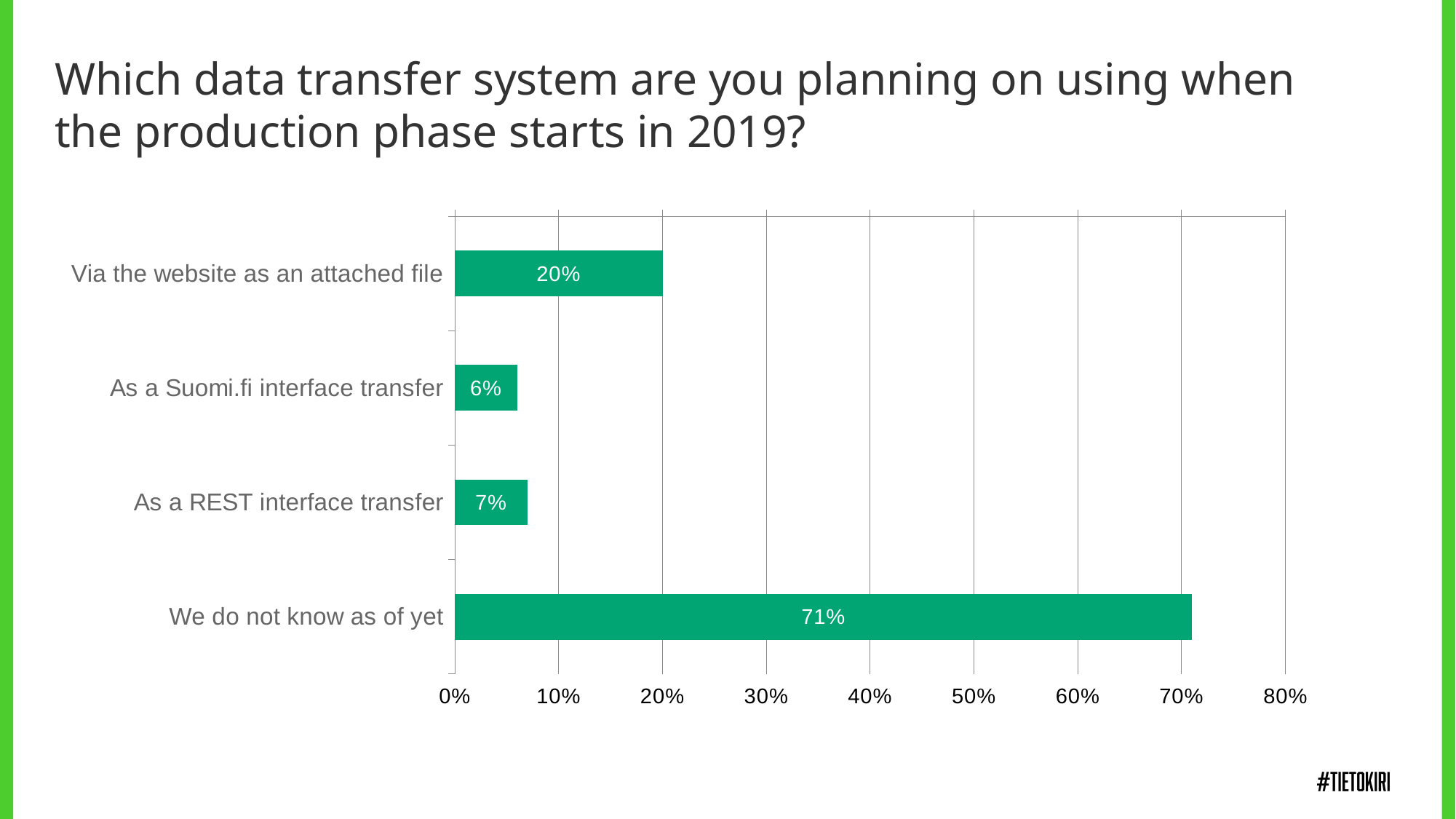
What is the difference between 'We do not know as of yet' and 'Via the website as an attached file'? 51% Which is larger: 'Via the website as an attached file' or 'As a REST interface transfer'? Via the website as an attached file What kind of chart is shown on the slide? Bar chart What is the value for 'As a REST interface transfer'? 7% What is the value for 'As a Suomi.fi interface transfer'? 6% Which category has the lowest value? As a Suomi.fi interface transfer Which category has the highest value? We do not know as of yet What is the difference between the REST interface transfer and the Suomi.fi interface transfer values? 1% What percentage of respondents plan to transfer data via the website as an attached file? 20% How many categories are shown in the chart? 4 What percentage of respondents answered 'We do not know as of yet'? 71% Is the value for 'We do not know as of yet' greater or less than 50%? greater